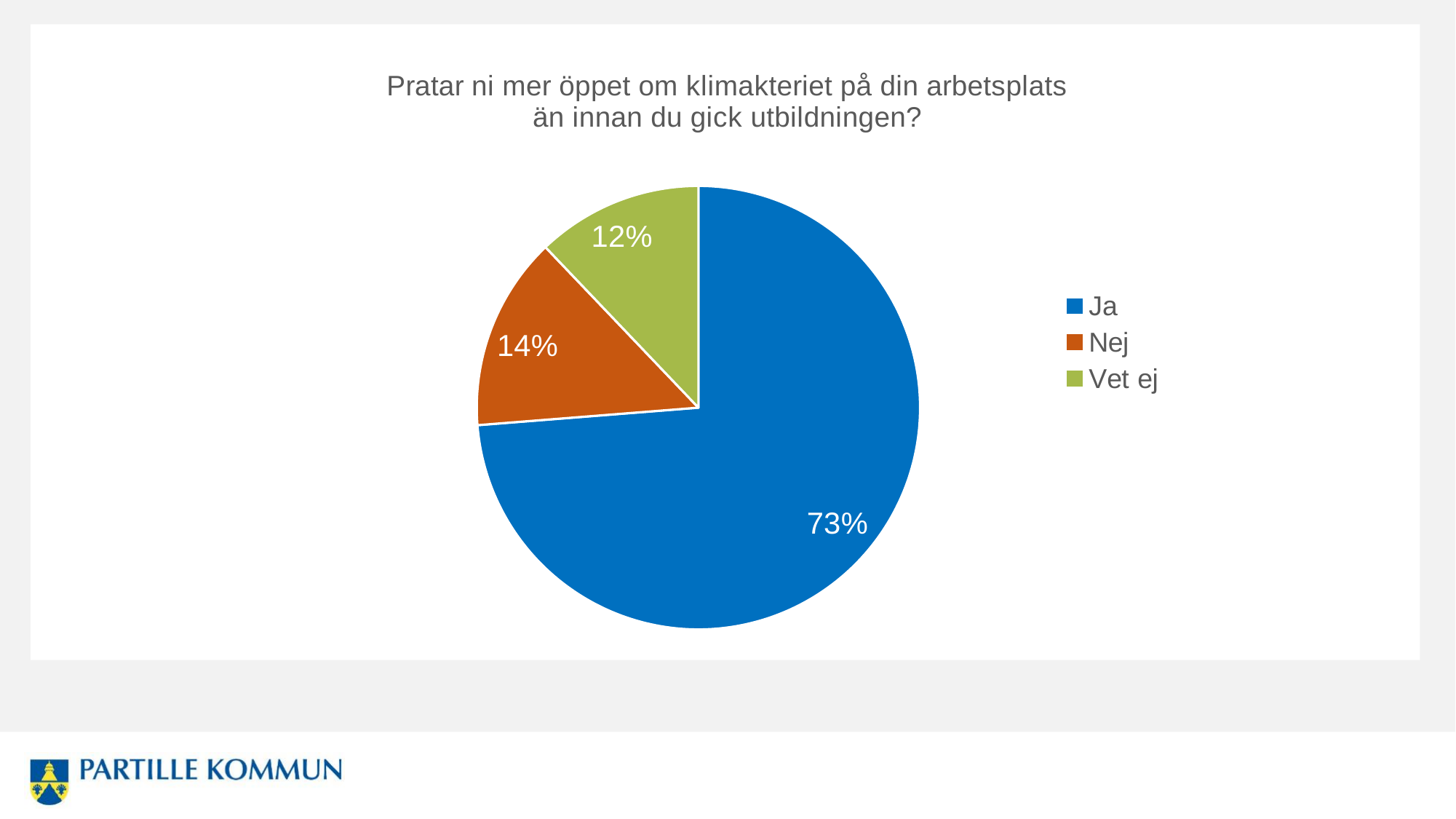
What is the difference in percentage points between "Nej" and "Vet ej"? 2 What kind of chart is shown on the slide? pie chart Which category has the smallest slice of the pie? Vet ej Which is larger, the share for "Ja" or the share for "Vet ej"? Ja What share of the pie does "Ja" represent? 73% What is the title of the chart? Pratar ni mer öppet om klimakteriet på din arbetsplats än innan du gick utbildningen? What share of the pie does "Vet ej" represent? 12% Which category has the largest slice of the pie? Ja How many categories does the pie chart have? 3 What share of the pie does "Nej" represent? 14% What is the difference in percentage points between "Ja" and "Nej"? 59 What colour is the slice for "Nej"? orange